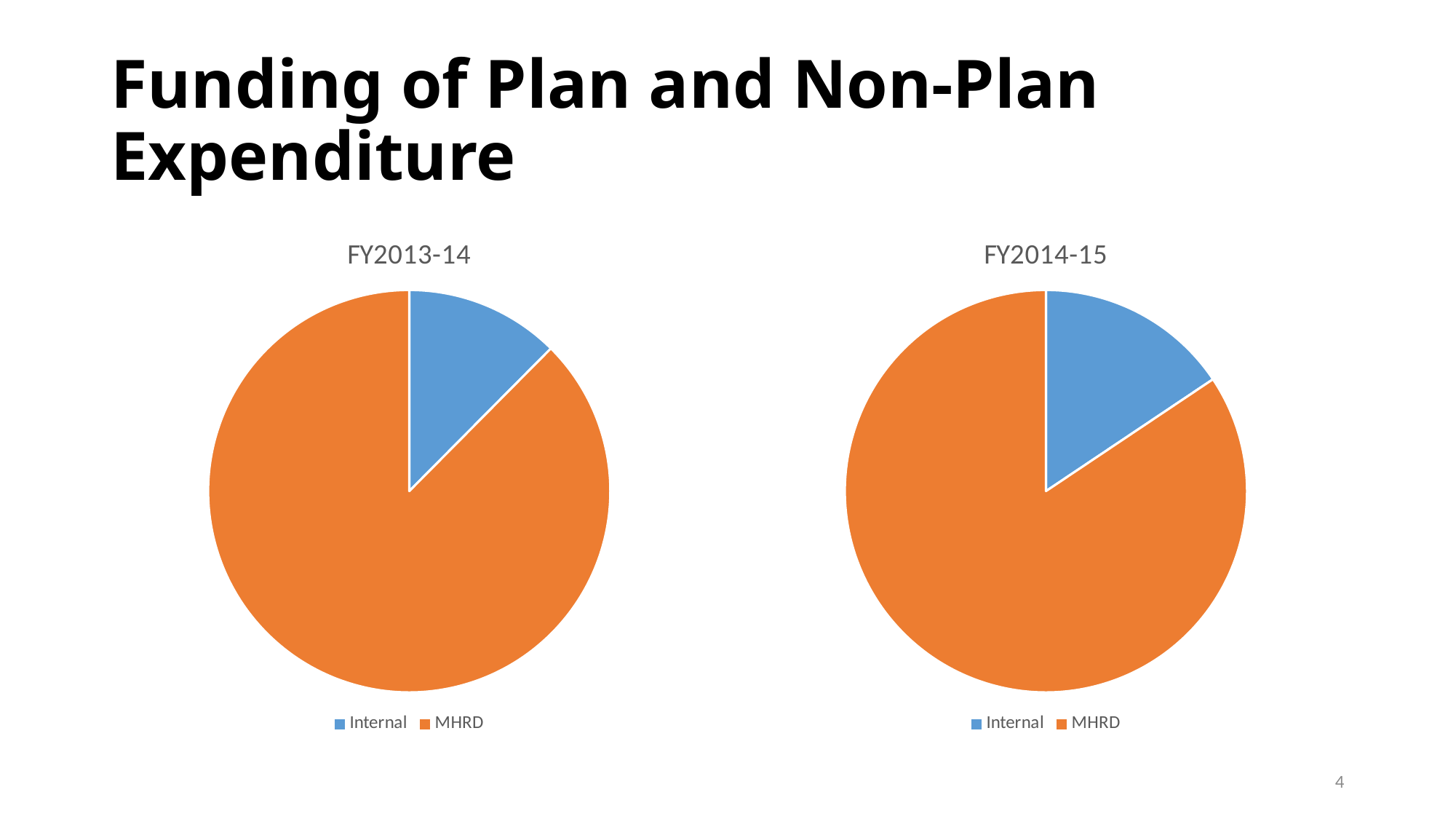
In the FY2014-15 chart, which is larger, the Internal slice or the MHRD slice? MHRD What is the title of the chart on the right of the slide? FY2014-15 What kind of chart is the FY2013-14 chart? Pie chart How many slices does the FY2014-15 pie chart have? 2 In the FY2013-14 chart, which funding source has the largest slice? MHRD In the FY2013-14 chart, which funding source has the smallest slice? Internal What kind of chart is the FY2014-15 chart? Pie chart In the FY2013-14 chart, what colour is the MHRD slice? Orange How many slices does the FY2013-14 pie chart have? 2 In the FY2014-15 chart, which funding source has the smallest slice? Internal How many entries does the legend of the FY2013-14 chart list? 2 In the FY2014-15 chart, which funding source has the largest slice? MHRD